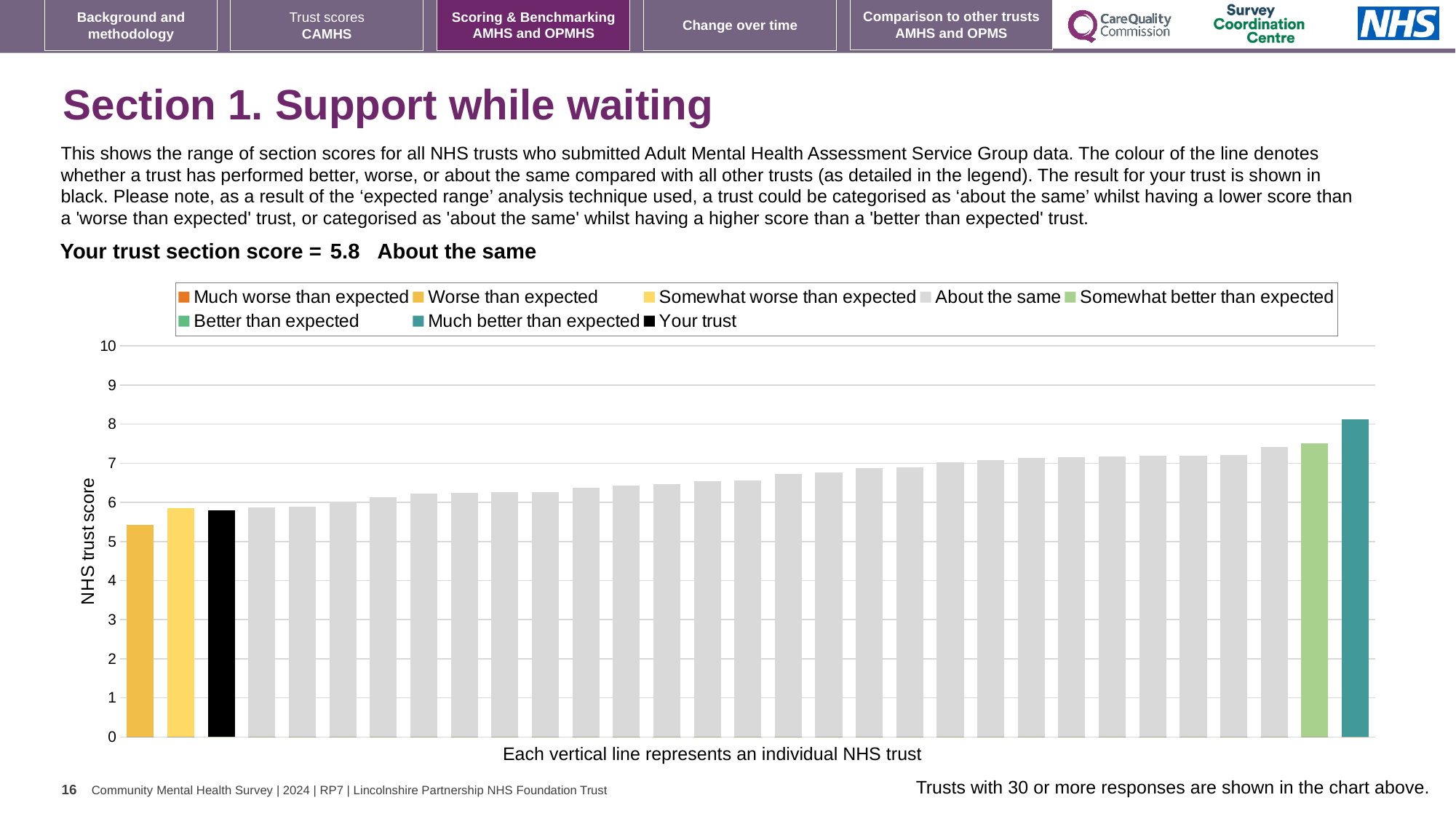
Is the value of the black 'Your trust' bar greater or less than 5? greater How many entries does the chart legend list? 8 What type of chart is shown on the slide? bar chart Which legend category does the lowest bar in the chart belong to? Worse than expected What is the section score for your trust shown on the slide? 5.8 Do the bar values rise or fall from left to right across the chart? rise What colour is the bar representing your trust? black Is the value of the leftmost (lowest) bar greater or less than 6? less Is the value of the tallest bar greater or less than 9? less Which legend category does the tallest bar in the chart belong to? Much better than expected Is the 'Your trust' bar higher or lower than the tallest bar in the chart? lower What is the label on the vertical axis of the chart? NHS trust score